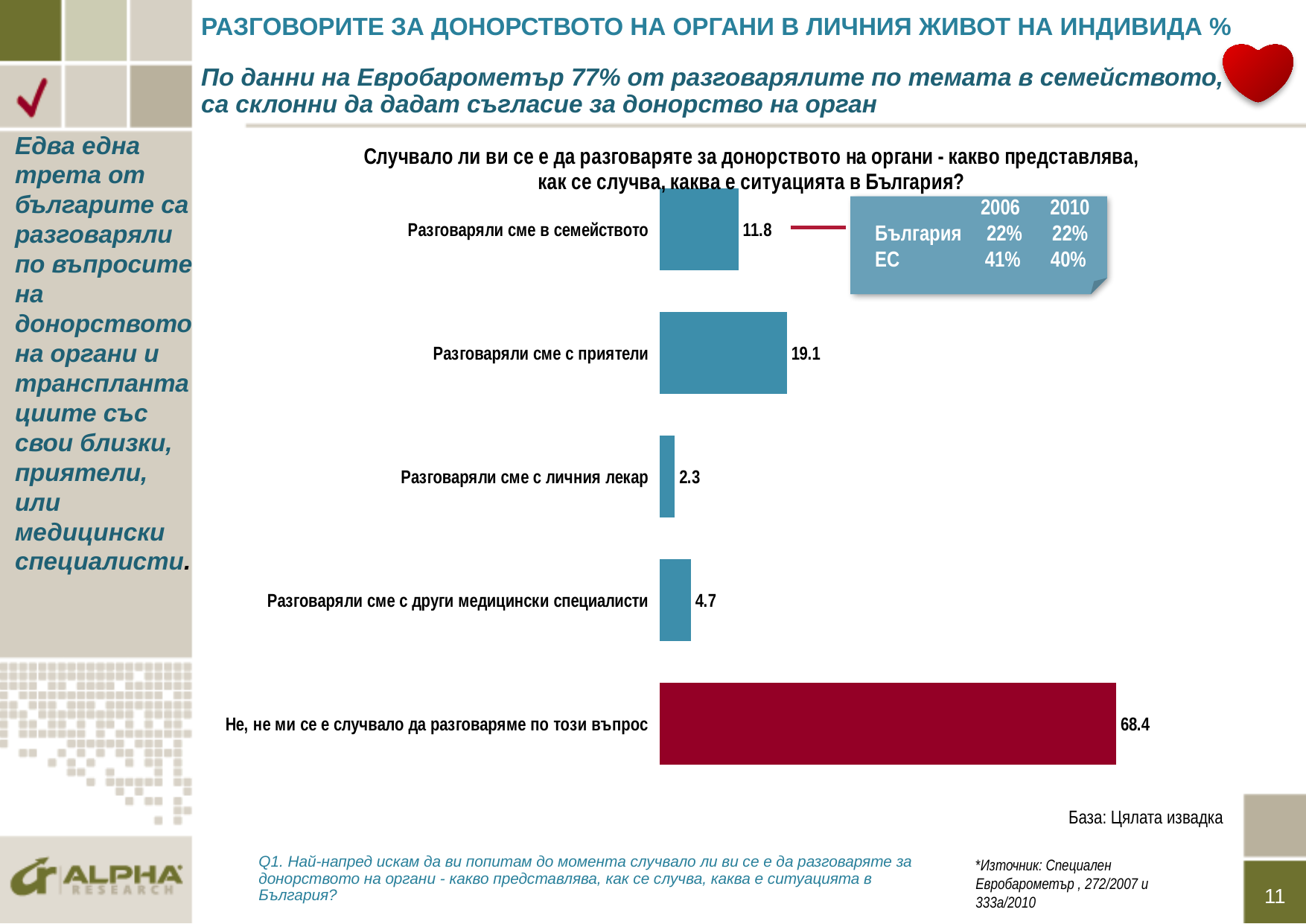
What value is shown for "Разговаряли сме в семейството"? 11.8 Which category has the highest value in the chart? Не, не ми се е случвало да разговаряме по този въпрос What value is shown for "Не, не ми се е случвало да разговаряме по този въпрос"? 68.4 What type of chart is shown on the slide? Bar chart What is the difference between the values for "Разговаряли сме с приятели" and "Разговаряли сме в семейството"? 7.3 Which is larger: the value for "Разговаряли сме с други медицински специалисти" or for "Разговаряли сме с личния лекар"? Разговаряли сме с други медицински специалисти What value is shown for "Разговаряли сме с приятели"? 19.1 In the callout table, what is the value for ЕС in 2006? 41% Which category has the lowest value in the chart? Разговаряли сме с личния лекар What value is shown for "Разговаряли сме с личния лекар"? 2.3 In the callout table, what is the value for България in 2010? 22% How many categories are shown in the bar chart? 5